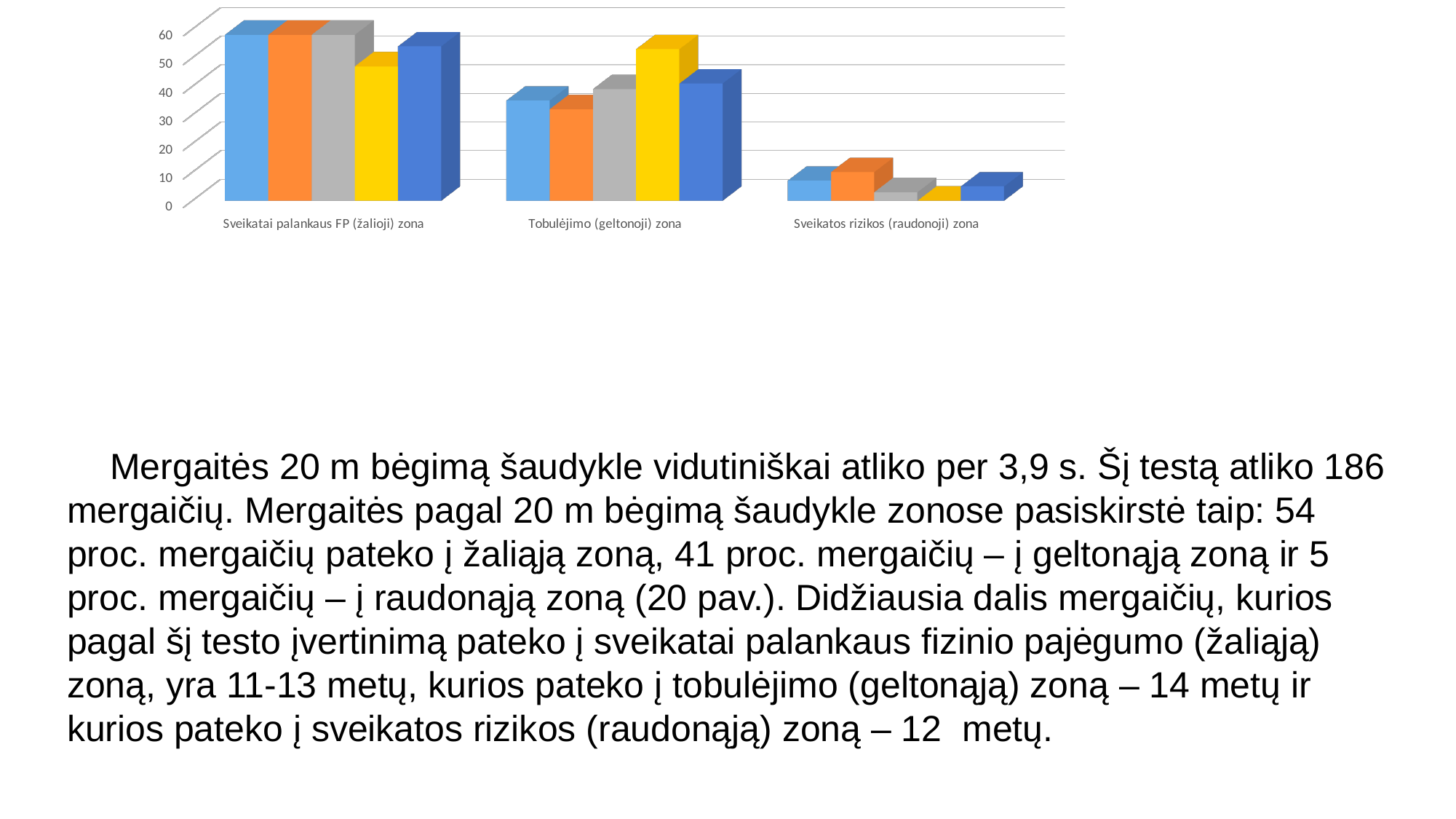
Do the values of the light blue bars rise or fall from left to right across the categories? fall How many bars are plotted for each category in the chart? 5 Is the orange bar for Sveikatos rizikos (raudonoji) zona greater or less than 20? less What kind of chart is shown on the slide? bar chart How many categories are shown on the x axis of the chart? 3 Is the light blue bar for Sveikatai palankaus FP (žalioji) zona greater or less than 50? greater What is the highest tick value shown on the vertical axis of the chart? 60 For the light blue bars, which category has the highest value? Sveikatai palankaus FP (žalioji) zona For the light blue bars, which category has the lowest value? Sveikatos rizikos (raudonoji) zona In the Sveikatos rizikos (raudonoji) zona category, which is larger: the orange bar or the yellow bar? the orange bar In the Tobulėjimo (geltonoji) zona category, which is larger: the yellow bar or the orange bar? the yellow bar Is the yellow bar for Tobulėjimo (geltonoji) zona greater or less than 40? greater